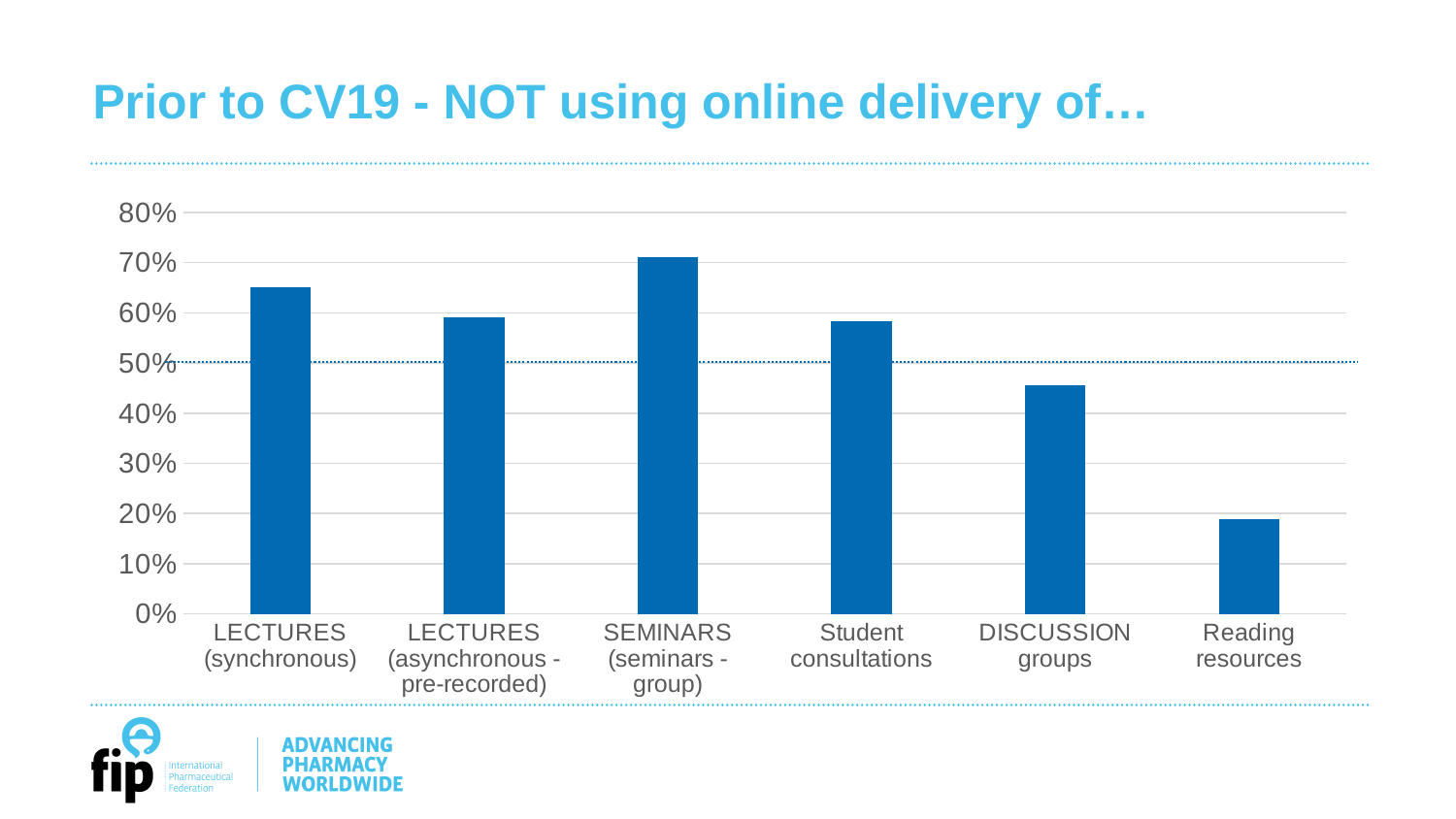
Which category has the highest bar? SEMINARS (seminars - group) How many categories are shown on the x axis of the chart? 6 What is the title of the slide containing the chart? Prior to CV19 - NOT using online delivery of… Is the value for DISCUSSION groups greater or less than 50%? less Which category has the lowest bar? Reading resources Which is larger, the value for Reading resources or the value for Student consultations? Student consultations Is the value for Reading resources greater or less than 20%? less Which is larger, the value for LECTURES (synchronous) or the value for DISCUSSION groups? LECTURES (synchronous) Is the value for SEMINARS (seminars - group) greater or less than 70%? greater What kind of chart is shown on the slide? bar chart